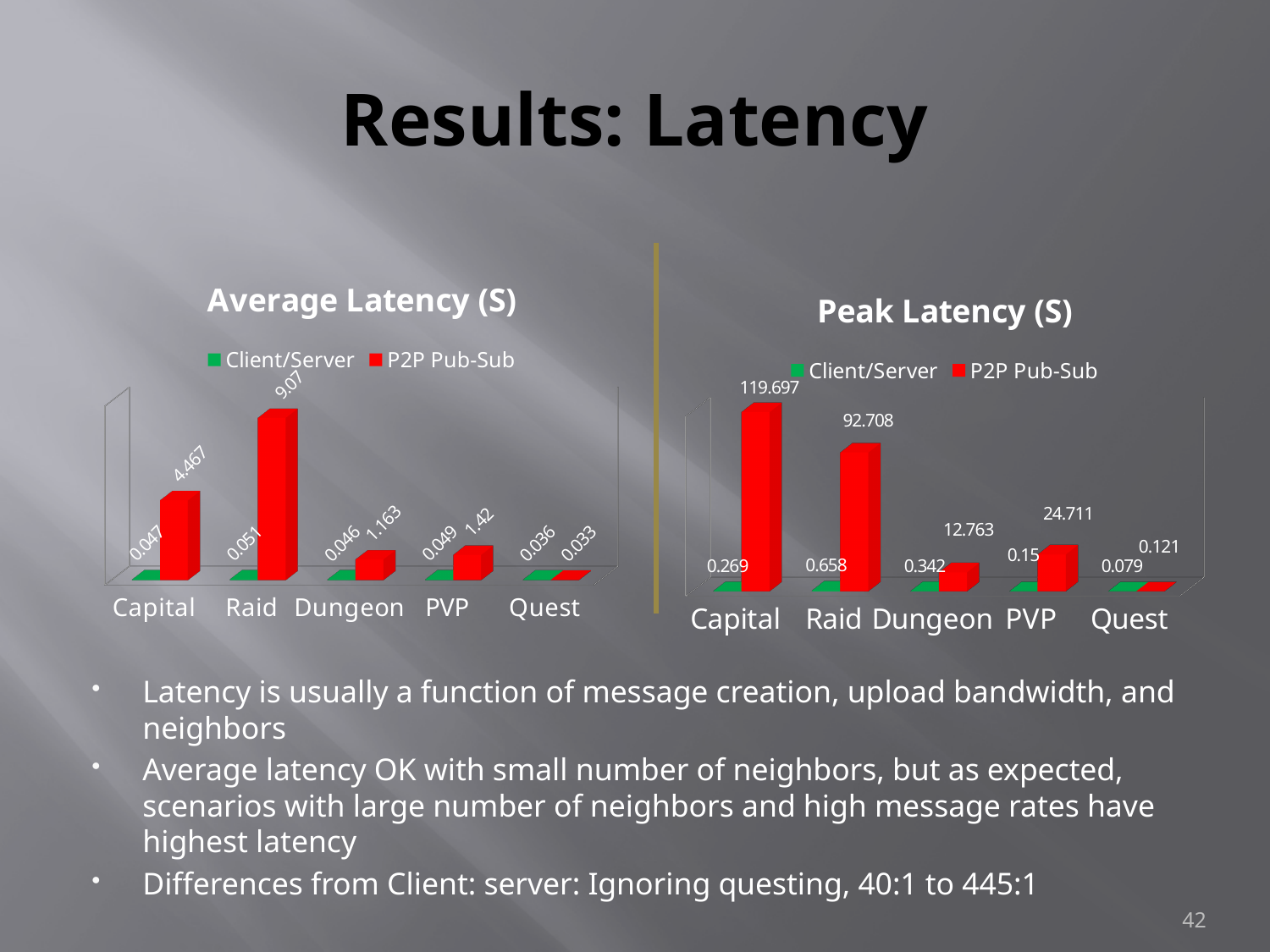
In the Average Latency (S) chart, which category has the lowest P2P Pub-Sub value? Quest How many categories are shown on the x axis of the Peak Latency (S) chart? 5 How many series does the legend of the Average Latency (S) chart list? 2 In the Average Latency (S) chart, what is the difference between the P2P Pub-Sub values for Raid and Capital? 4.603 In the Peak Latency (S) chart, what is the Client/Server value for Raid? 0.658 In the Average Latency (S) chart, what is the Client/Server value for Quest? 0.036 In the Peak Latency (S) chart, what is the P2P Pub-Sub value for Dungeon? 12.763 In the Average Latency (S) chart, which is larger: the P2P Pub-Sub value for PVP or for Dungeon? PVP In the Peak Latency (S) chart, which category has the highest P2P Pub-Sub value? Capital What kind of chart is the Peak Latency (S) chart? Bar chart In the Peak Latency (S) chart, what is the difference between the P2P Pub-Sub values for Capital and Raid? 26.989 In the Average Latency (S) chart, what is the P2P Pub-Sub value for Raid? 9.07